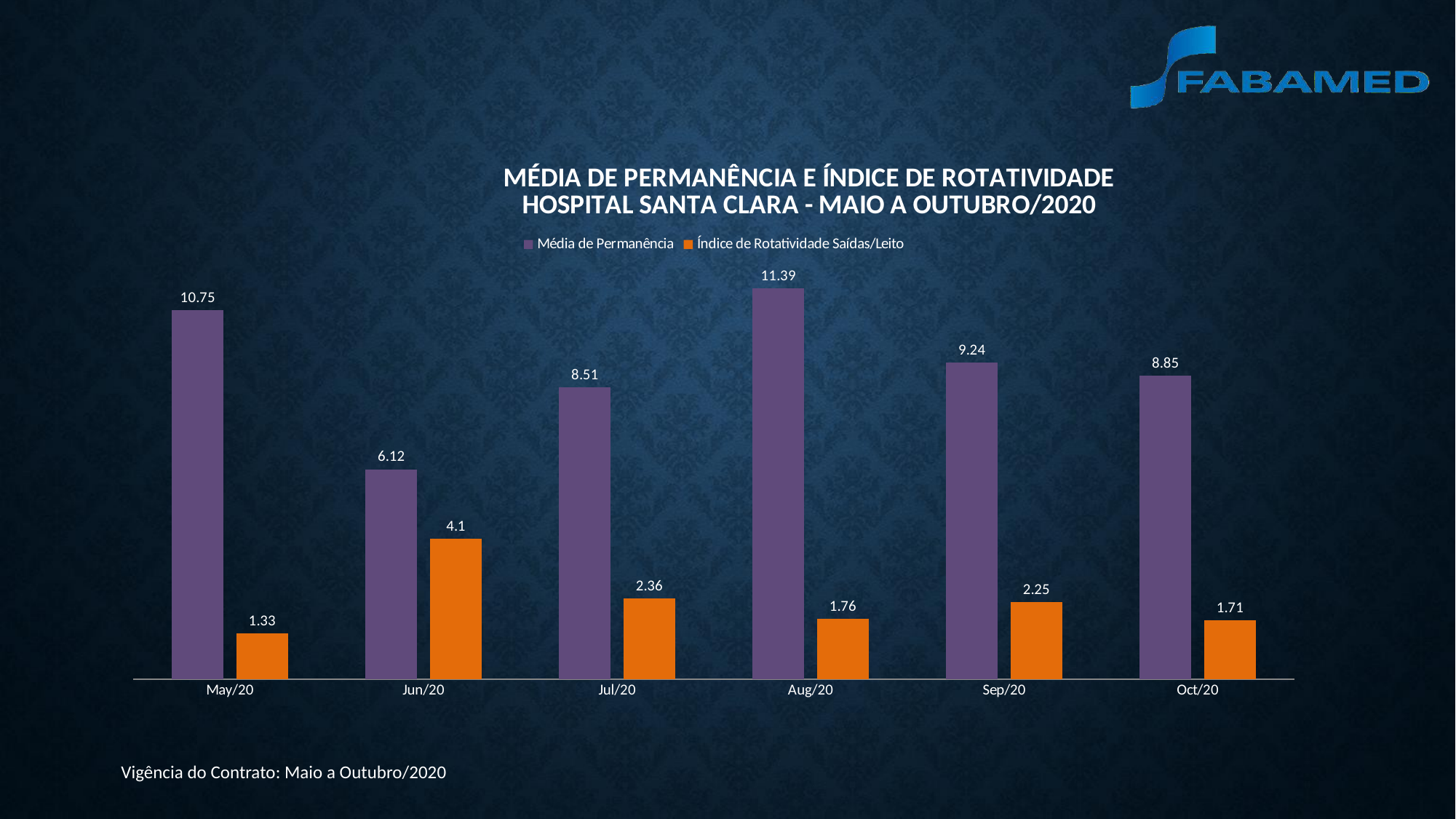
What is the difference between the Média de Permanência for Aug/20 and Sep/20? 2.15 What is the Média de Permanência value for Oct/20? 8.85 What is the Média de Permanência value for Aug/20? 11.39 Which is larger, the Índice de Rotatividade Saídas/Leito for Jul/20 or for Sep/20? Jul/20 How many months are shown on the x axis? 6 Which colour represents Índice de Rotatividade Saídas/Leito in the chart? Orange How many series does the legend list? 2 What kind of chart is shown on the slide? Bar chart What is the Índice de Rotatividade Saídas/Leito value for Jun/20? 4.1 Which month has the lowest Média de Permanência? Jun/20 Which month has the lowest Índice de Rotatividade Saídas/Leito? May/20 Which month has the highest Média de Permanência? Aug/20